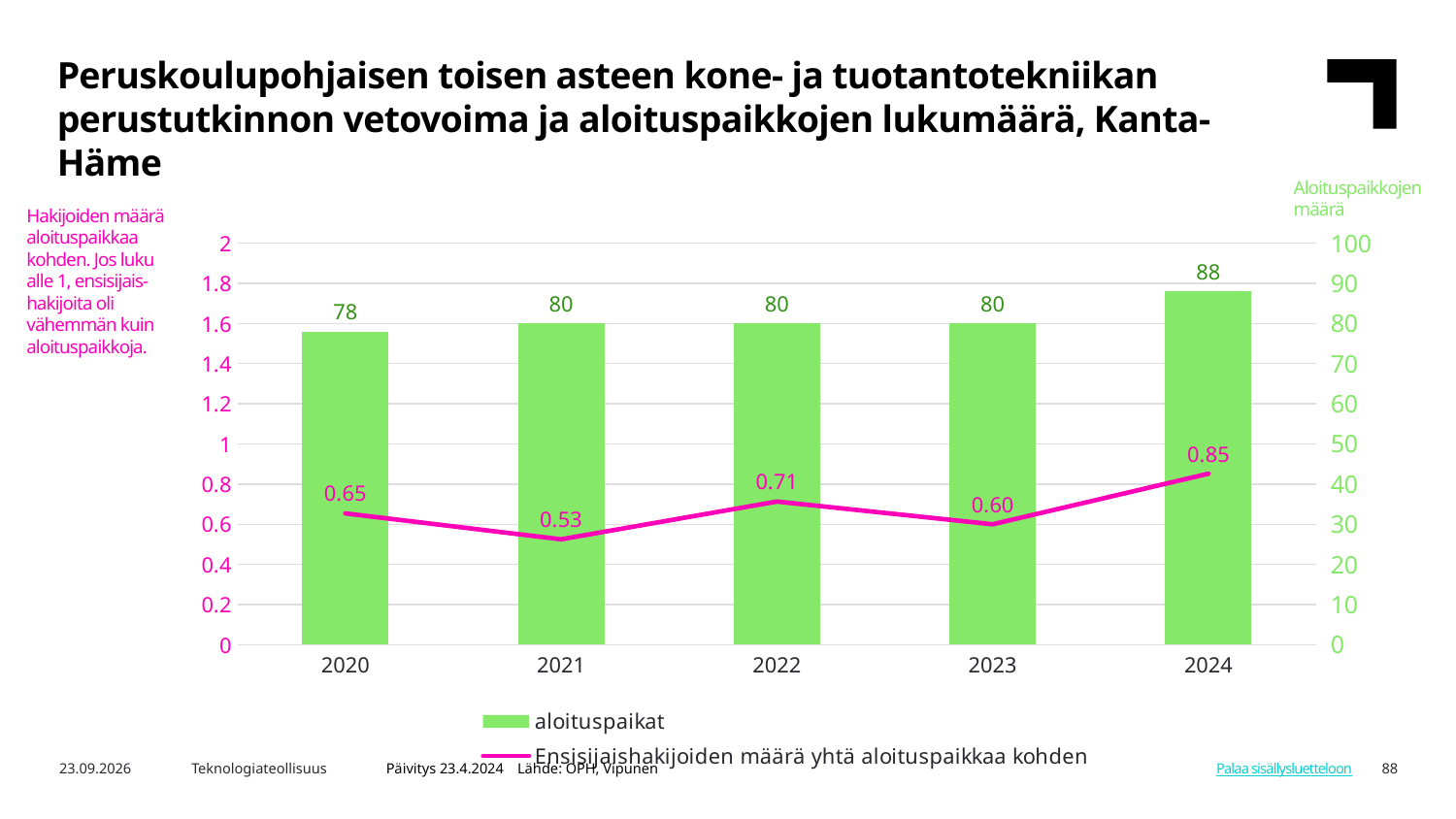
Which year has the lowest value for aloituspaikat? 2020 What is the value of aloituspaikat for 2020? 78 Which is larger, the Ensisijaishakijoiden määrä yhtä aloituspaikkaa kohden value for 2022 or for 2023? 2022 What is the value of aloituspaikat for 2024? 88 How many series does the legend list? 2 What is the difference between the aloituspaikat values for 2024 and 2020? 10 How many years are shown on the x axis? 5 Does the Ensisijaishakijoiden määrä yhtä aloituspaikkaa kohden value rise or fall from 2023 to 2024? Rise What colour are the aloituspaikat bars? Green What is the value of Ensisijaishakijoiden määrä yhtä aloituspaikkaa kohden for 2021? 0.53 Which year has the highest value for Ensisijaishakijoiden määrä yhtä aloituspaikkaa kohden? 2024 What kinds of chart are combined on this slide? Bar chart and line chart